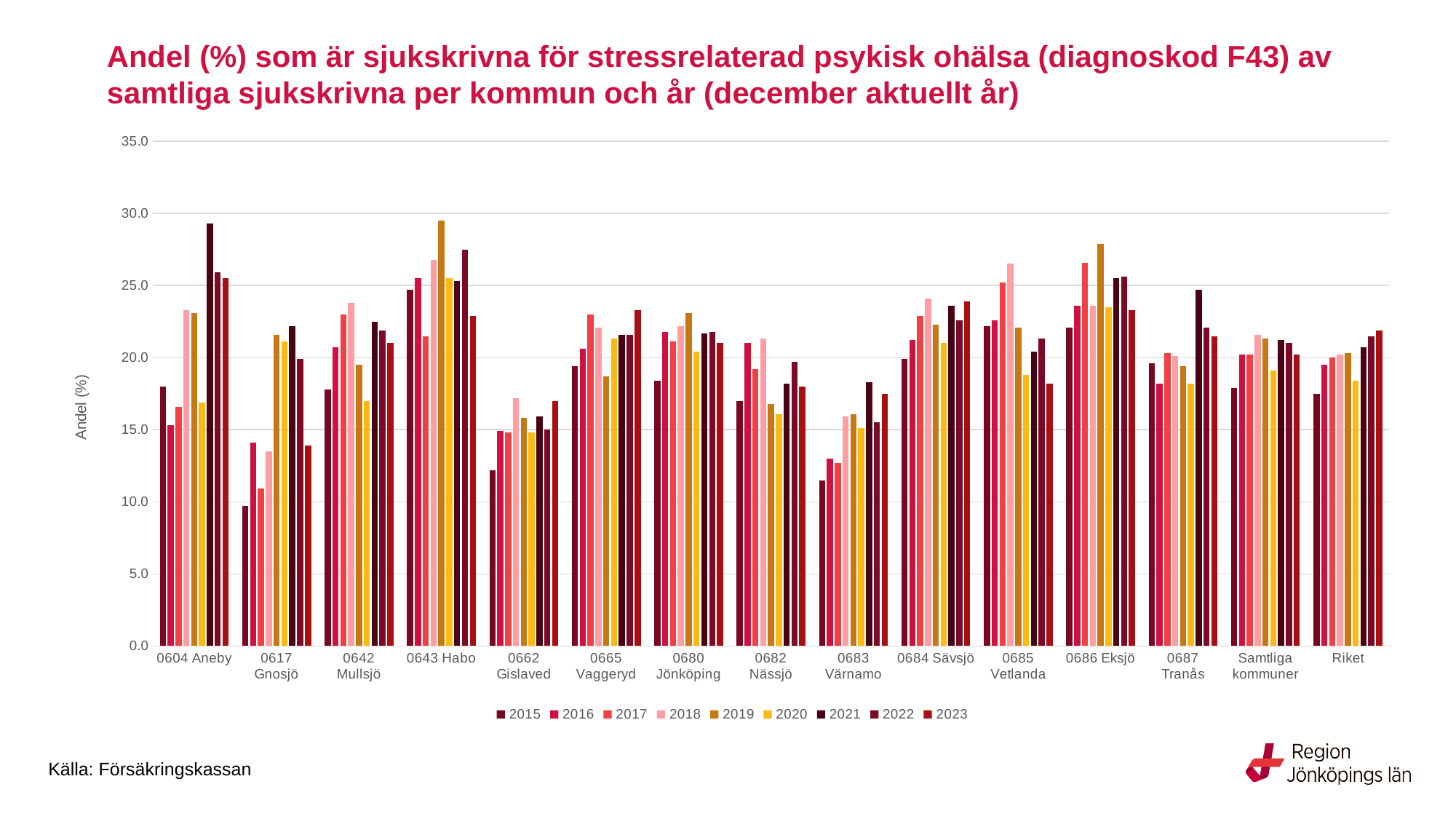
Which category has the highest 2019 value? 0643 Habo Is the 2019 value for 0643 Habo greater or less than 25? greater Is the 2021 value for 0604 Aneby greater or less than 25? greater How many series does the legend list? 9 Is the 2015 value for 0617 Gnosjö greater or less than 10? less What kind of chart is shown on the slide? bar chart Which is larger, the 2015 value for 0604 Aneby or the 2015 value for 0617 Gnosjö? 0604 Aneby What source is cited below the chart? Försäkringskassan How many categories (municipalities/groups) are shown on the x axis? 15 Which category has the lowest 2015 value? 0617 Gnosjö